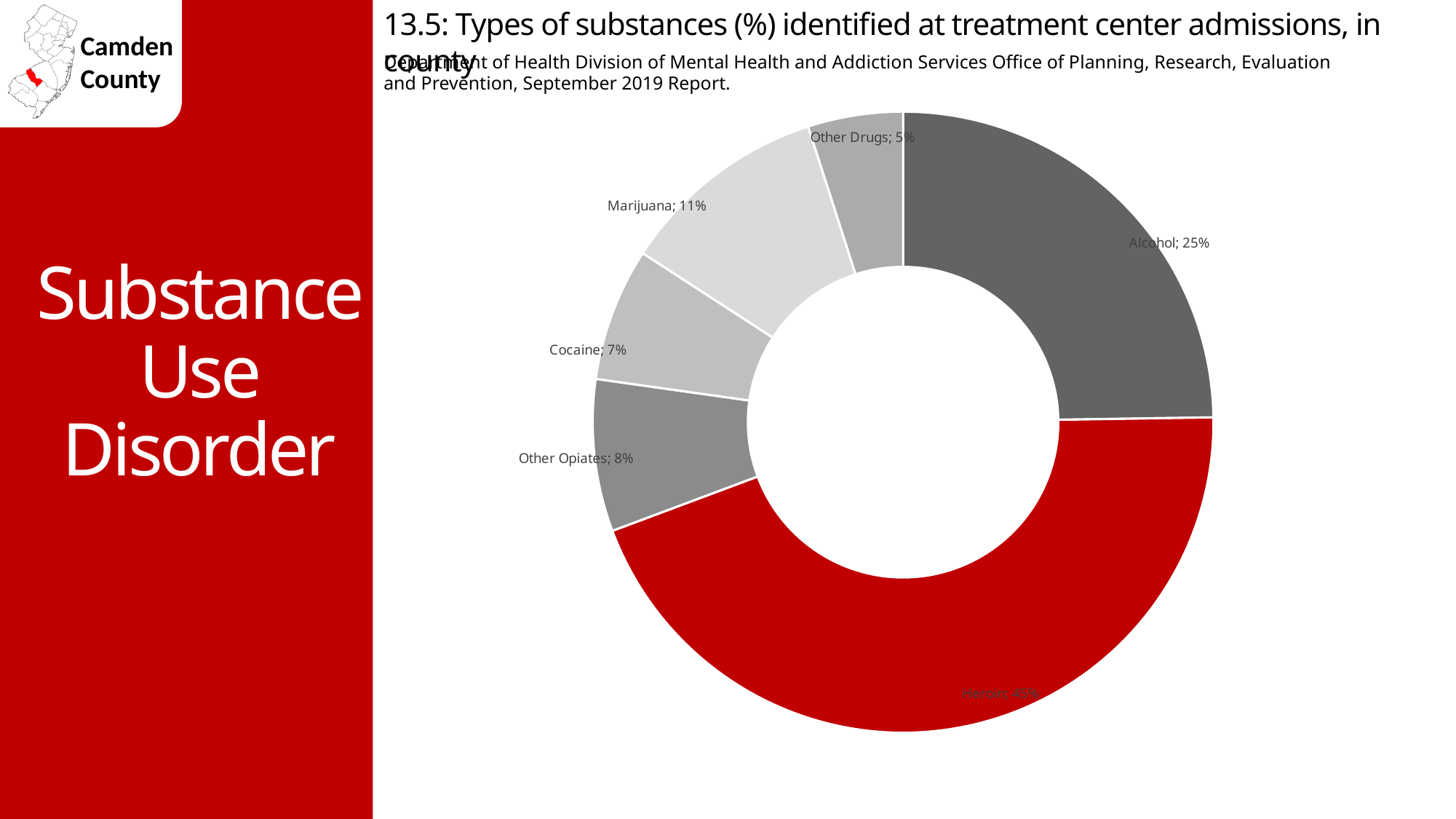
What percentage of treatment center admissions is attributed to Alcohol? 25% Which substance has the smallest share of treatment center admissions? Other Drugs Which slice of the chart is colored red? Heroin What type of chart is used on this slide? Pie chart (donut) What percentage of treatment center admissions is attributed to Heroin? 45% What percentage is shown for Marijuana? 11% What is the difference in percentage points between Heroin and Alcohol? 20 What percentage is shown for Cocaine? 7% What percentage is shown for Other Opiates? 8% How many substance categories are shown in the chart? 6 Which substance has the largest share of treatment center admissions? Heroin Which has a larger share, Marijuana or Cocaine? Marijuana